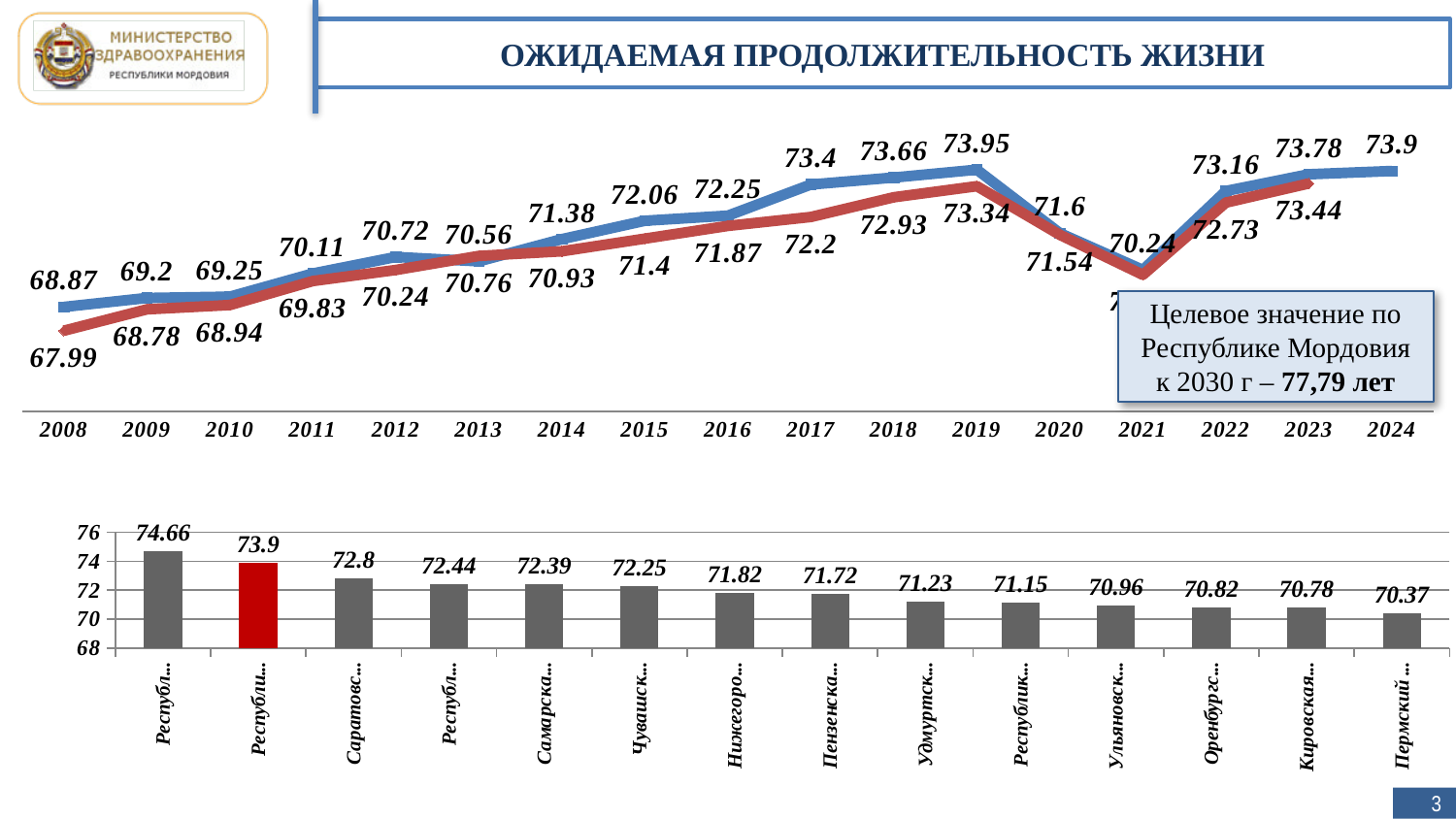
In the top line chart, does the blue line rise or fall from 2019 to 2021? fall In the top line chart, what is the value of the blue line for 2024? 73.9 In the bottom bar chart, what is the value of the red bar? 73.9 In the top line chart, what is the value of the red line for 2023? 73.44 In the top line chart, which is larger in 2013: the blue line or the red line? the red line In the top line chart, what is the difference between the blue line and the red line in 2008? 0.88 In the bottom bar chart, what is the highest value shown? 74.66 In the top line chart, what is the value of the red line for 2008? 67.99 In the top line chart, how many years are shown on the x axis? 17 In the top line chart, what is the value of the blue line for 2019? 73.95 In the top line chart, in which year does the blue line reach its lowest value? 2008 What type of chart is the bottom chart? bar chart